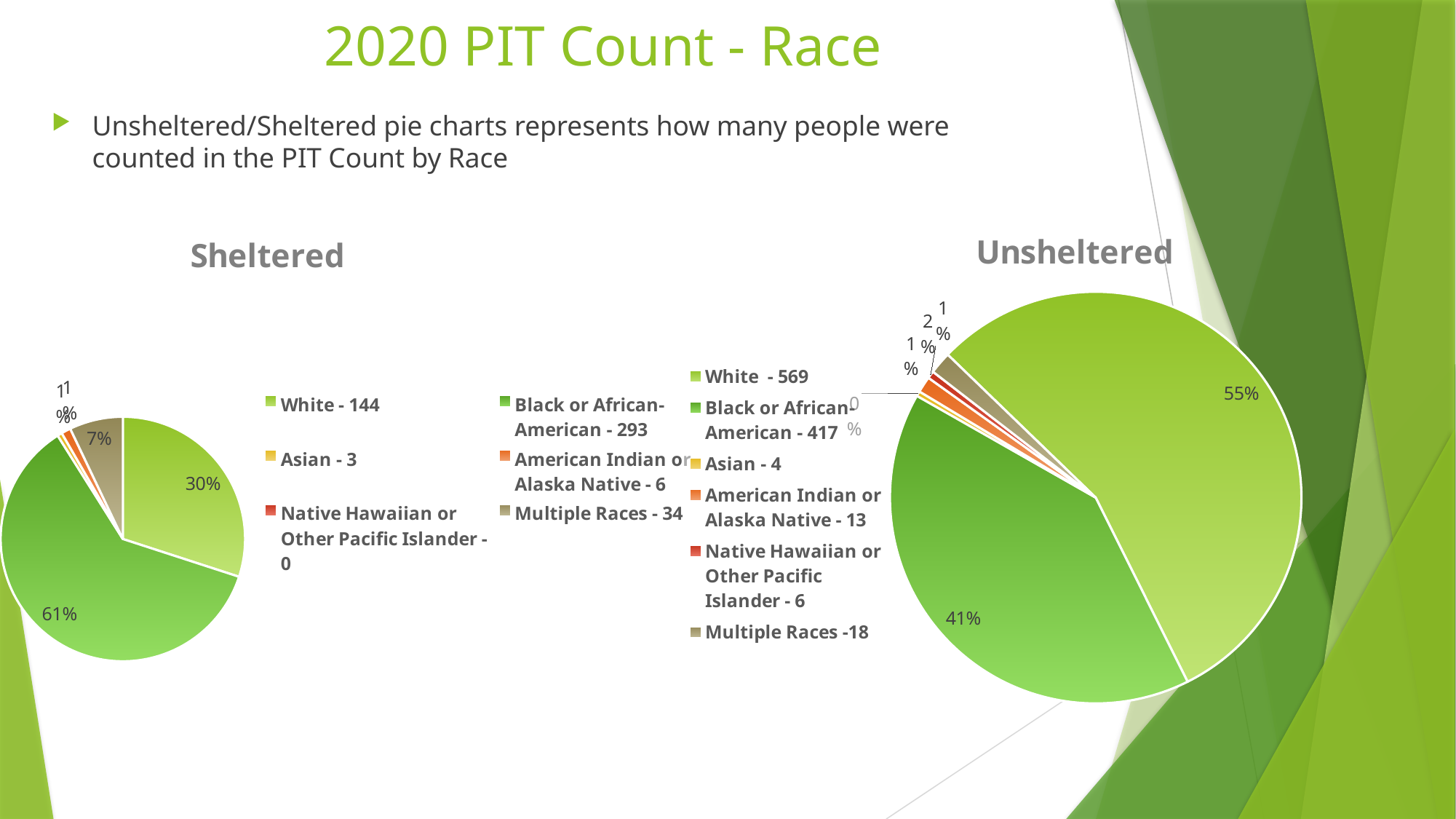
What kind of chart is the Sheltered chart? pie chart In the Unsheltered chart, what share of the pie is White? 55% In the Sheltered chart, what share of the pie is Black or African-American? 61% In the Unsheltered chart, what is the difference between the White count (569) and the Black or African-American count (417) shown in the legend? 152 In the Unsheltered chart, which race has the largest slice? White In the Sheltered chart, how many people are listed in the legend for Multiple Races? 34 In the Sheltered chart, what share of the pie is White? 30% In the Sheltered chart, which race has the largest slice? Black or African-American How many race categories does the legend of the Unsheltered chart list? 6 In the Unsheltered chart, how many people are listed in the legend for Black or African-American? 417